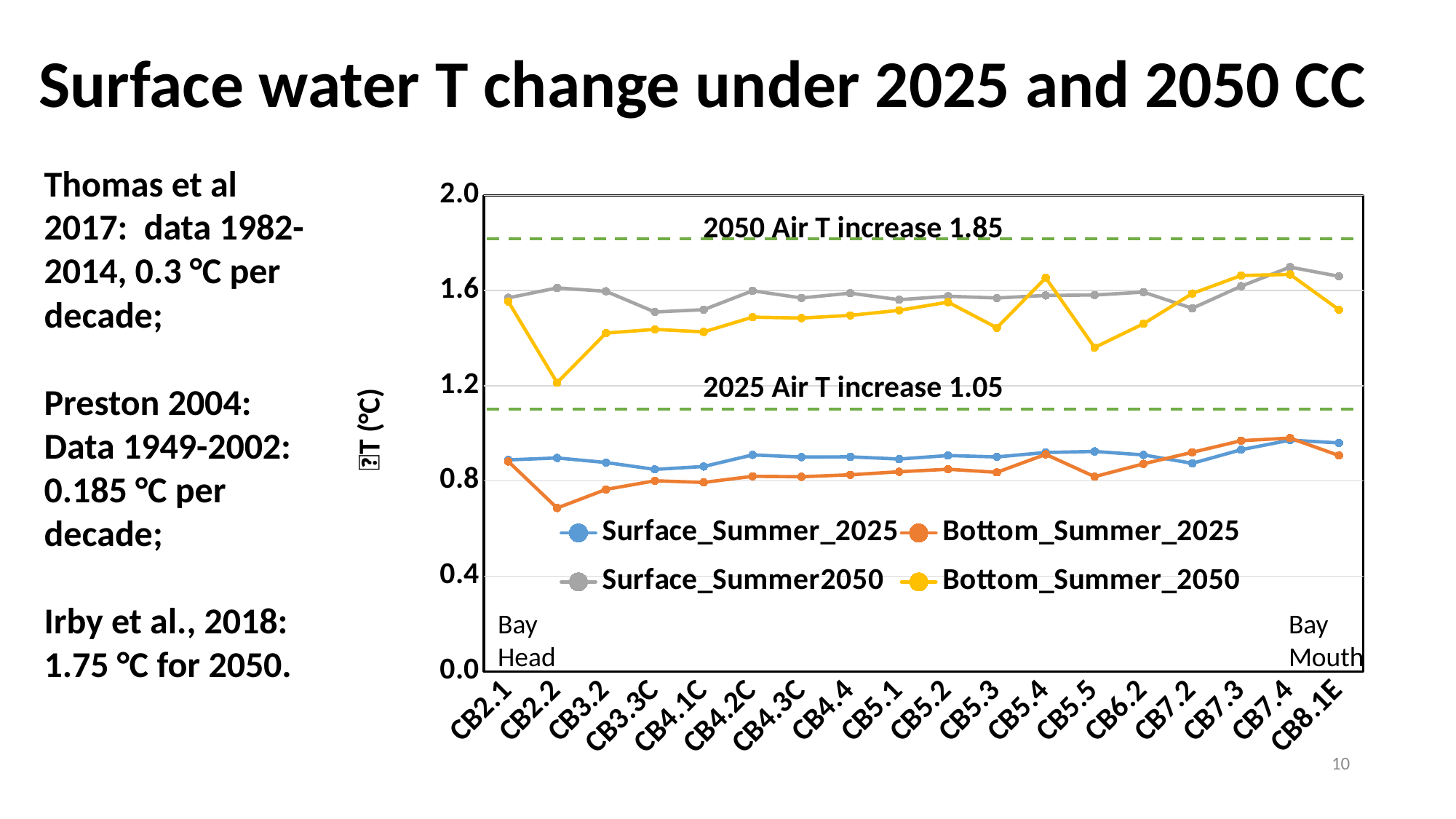
Is the Bottom_Summer_2050 value at CB2.2 greater or less than 1.6? less At which station is the Surface_Summer2050 series highest? CB7.4 Is the Bottom_Summer_2025 value at CB2.2 greater or less than 0.8? less What value is given for the 2050 Air T increase dashed reference line? 1.85 At CB5.5, which is larger: Surface_Summer2050 or Bottom_Summer_2050? Surface_Summer2050 At CB5.4, which is larger: Bottom_Summer_2050 or Surface_Summer2050? Bottom_Summer_2050 How many stations are plotted along the x axis of the chart? 18 How many series does the chart legend list? 4 What kind of chart is shown on the slide? line chart At which station is the Bottom_Summer_2050 series lowest? CB2.2 What value is given for the 2025 Air T increase dashed reference line? 1.05 At which station is the Bottom_Summer_2025 series lowest? CB2.2